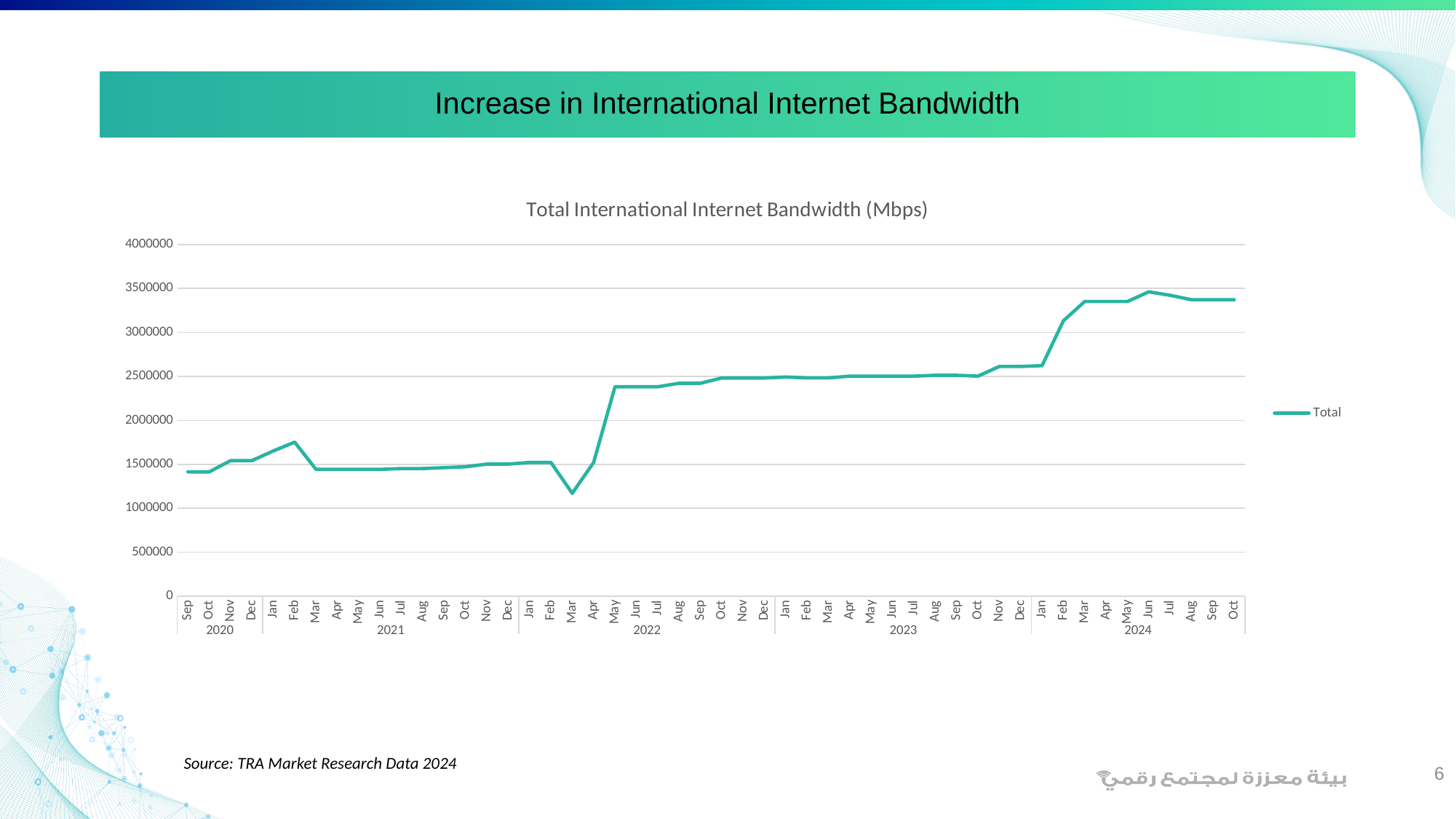
Which is larger, the value for Feb 2021 or the value for Mar 2021? Feb 2021 Overall, does the Total line rise or fall from Sep 2020 to Oct 2024? rise Is the value for Dec 2023 greater or less than 2500000? greater Is the value for May 2022 greater or less than 2000000? greater What kind of chart is shown on the slide? line chart In which month and year does the Total line reach its highest value? Jun 2024 How many series does the legend list? 1 In which month and year does the Total line reach its lowest value? Mar 2022 What is the title of the chart? Total International Internet Bandwidth (Mbps) What is the name of the series shown in the legend? Total Is the value for Mar 2022 greater or less than 1500000? less